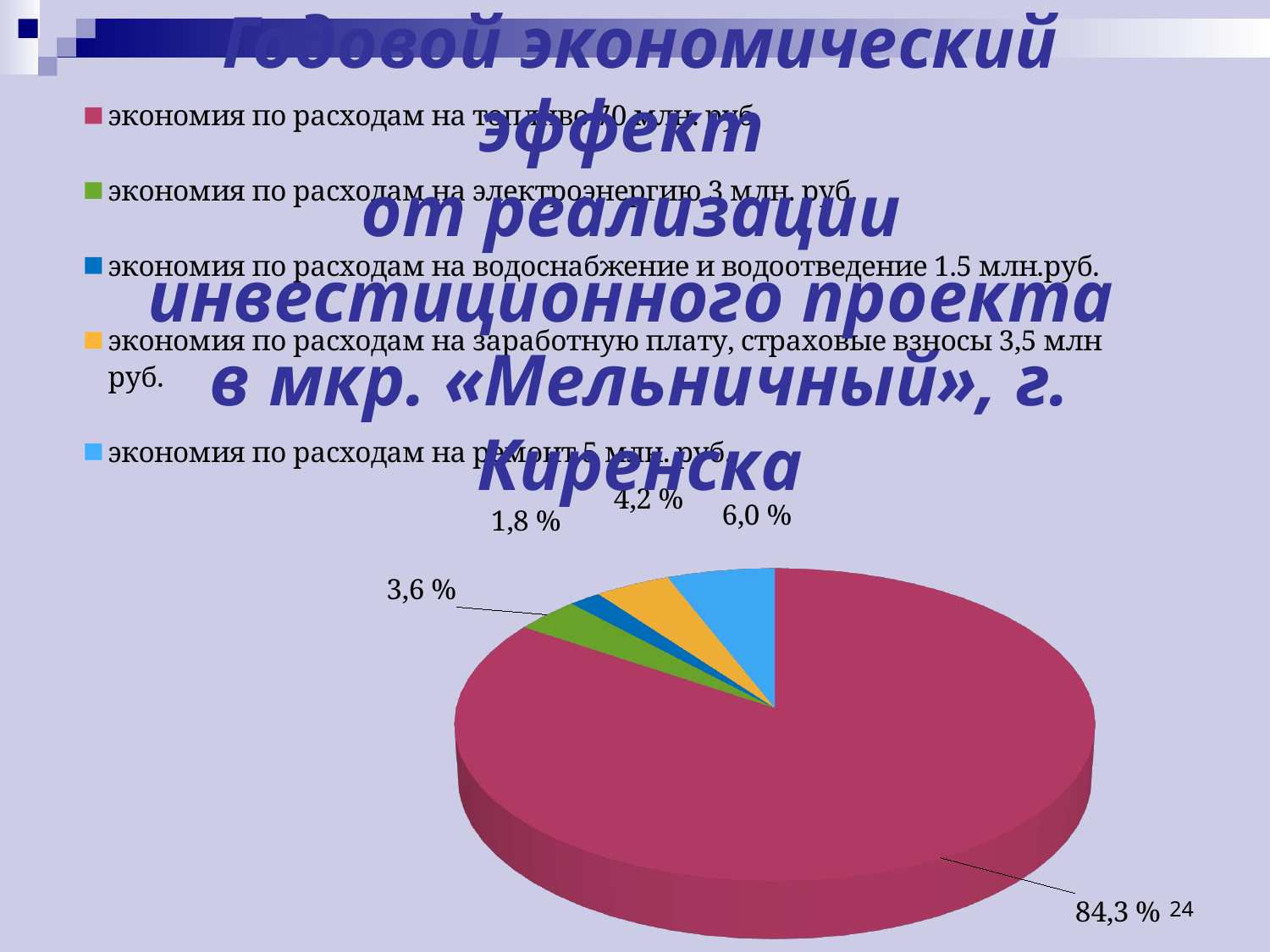
What share of the pie is labelled for экономия по расходам на заработную плату, страховые взносы? 4,2 % What is the difference in percentage points between the share for экономия по расходам на топливо and the share for экономия по расходам на ремонт? 78,3 % What kind of chart is shown on the slide? pie chart What share of the pie is labelled for экономия по расходам на топливо? 84,3 % What share of the pie is labelled for экономия по расходам на ремонт? 6,0 % How many entries does the legend of the pie chart list? 5 Which category has the smallest share of the pie chart? экономия по расходам на водоснабжение и водоотведение Which category has the largest share of the pie chart? экономия по расходам на топливо How many slices does the pie chart have? 5 Which is larger: the share for экономия по расходам на ремонт or the share for экономия по расходам на электроэнергию? экономия по расходам на ремонт